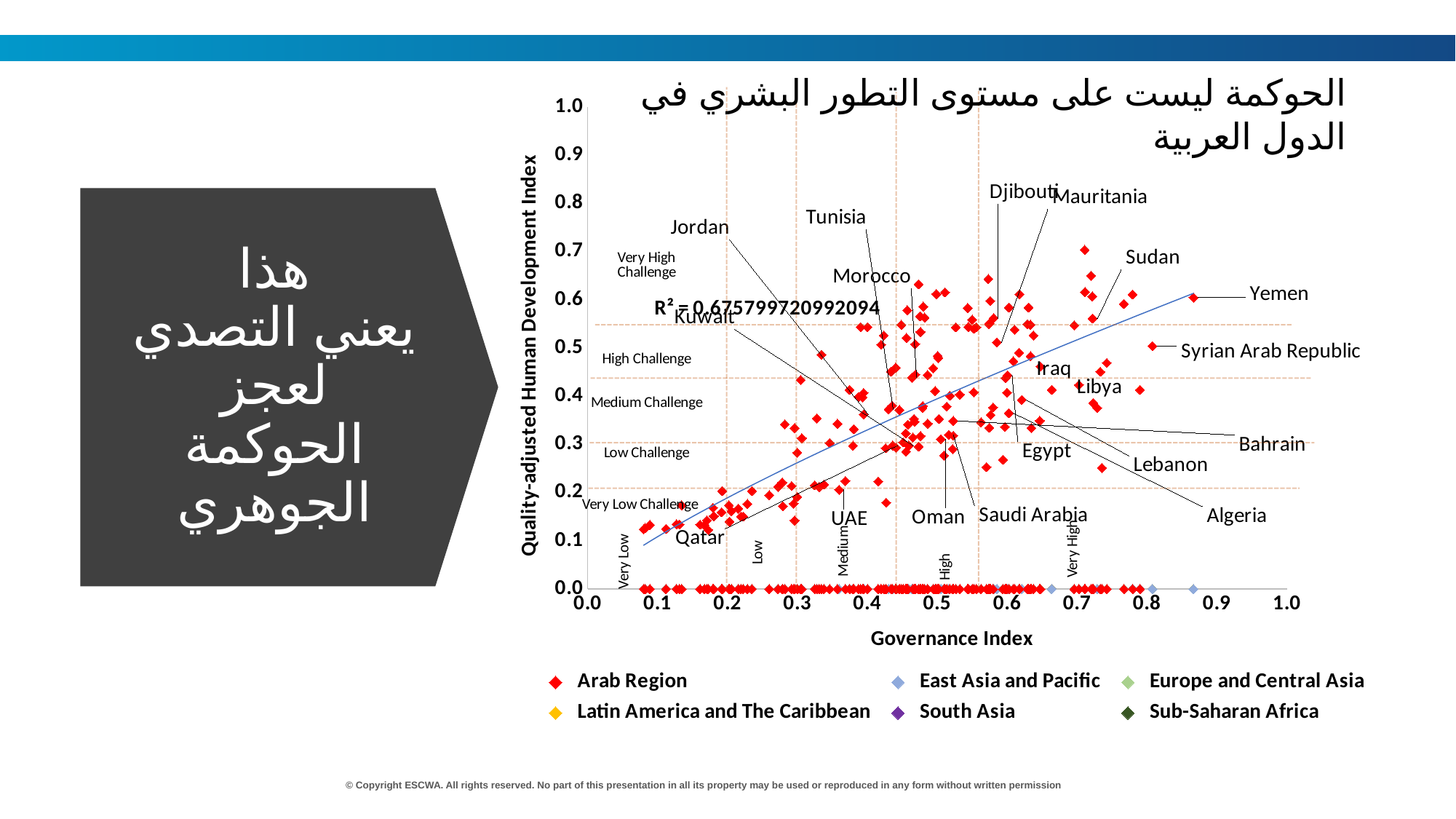
Which has the higher Governance Index, Yemen or Qatar? Yemen Is the Governance Index value for Yemen greater or less than 0.8? greater What is the title of the vertical axis of the chart? Quality-adjusted Human Development Index Is the Quality-adjusted Human Development Index value for Qatar greater or less than 0.2? less What is the title of the horizontal axis of the chart? Governance Index How many series does the chart legend list? 6 Among the labelled countries, which has the lowest Governance Index? Qatar Among the labelled countries, which has the highest Governance Index? Yemen Is the Quality-adjusted Human Development Index value for Sudan greater or less than 0.5? greater Does the Quality-adjusted Human Development Index generally rise or fall as the Governance Index increases along the x axis? rise What R² value is printed on the chart? R² = 0.675799720992094 What kind of chart is shown on the slide? scatter chart